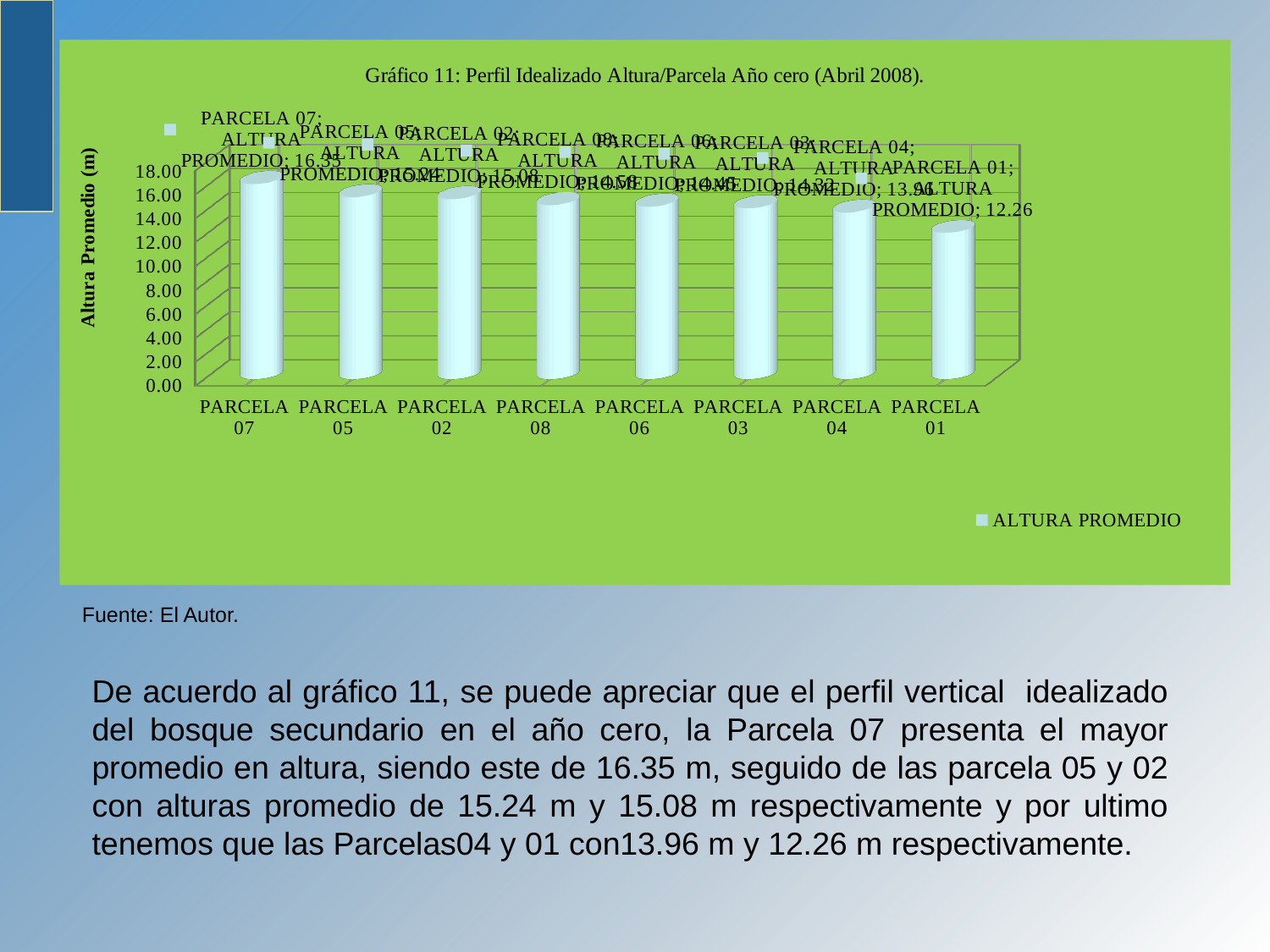
What is the ALTURA PROMEDIO value for PARCELA 05? 15.24 Is the value for PARCELA 06 greater or less than 16.00? less How many series does the chart legend list? 1 What is the ALTURA PROMEDIO value for PARCELA 07? 16.35 What is the ALTURA PROMEDIO value for PARCELA 04? 13.96 Which has a larger ALTURA PROMEDIO, PARCELA 07 or PARCELA 04? PARCELA 07 What kind of chart is shown on the slide? Bar chart What is the ALTURA PROMEDIO value for PARCELA 01? 12.26 What is the difference between the ALTURA PROMEDIO of PARCELA 07 and PARCELA 01? 4.09 Which parcela has the highest ALTURA PROMEDIO? PARCELA 07 How many parcelas are shown on the x axis of the chart? 8 Which parcela has the lowest ALTURA PROMEDIO? PARCELA 01